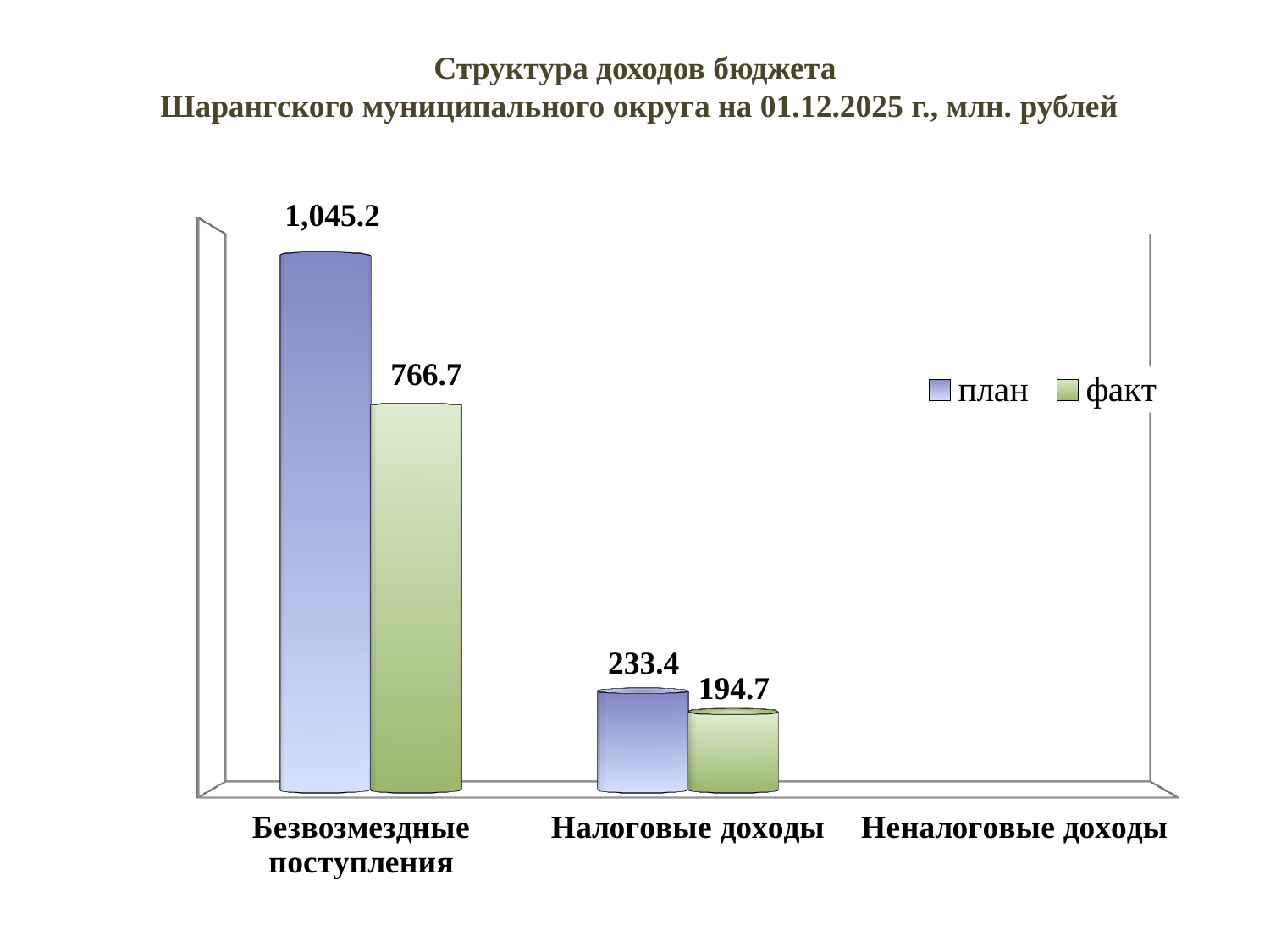
How many categories are shown on the x axis? 3 What is the difference between the план and факт values for Налоговые доходы? 38.7 Which series is shown in green in the legend? факт What is the план value for Налоговые доходы? 233.4 What is the факт value for Безвозмездные поступления? 766.7 What is the план value for Безвозмездные поступления? 1,045.2 What is the difference between the план and факт values for Безвозмездные поступления? 278.5 Which category has the highest план value? Безвозмездные поступления How many series does the legend list? 2 What kind of chart is shown on the slide? bar chart What is the факт value for Налоговые доходы? 194.7 Which is larger for Налоговые доходы, the план value or the факт value? план